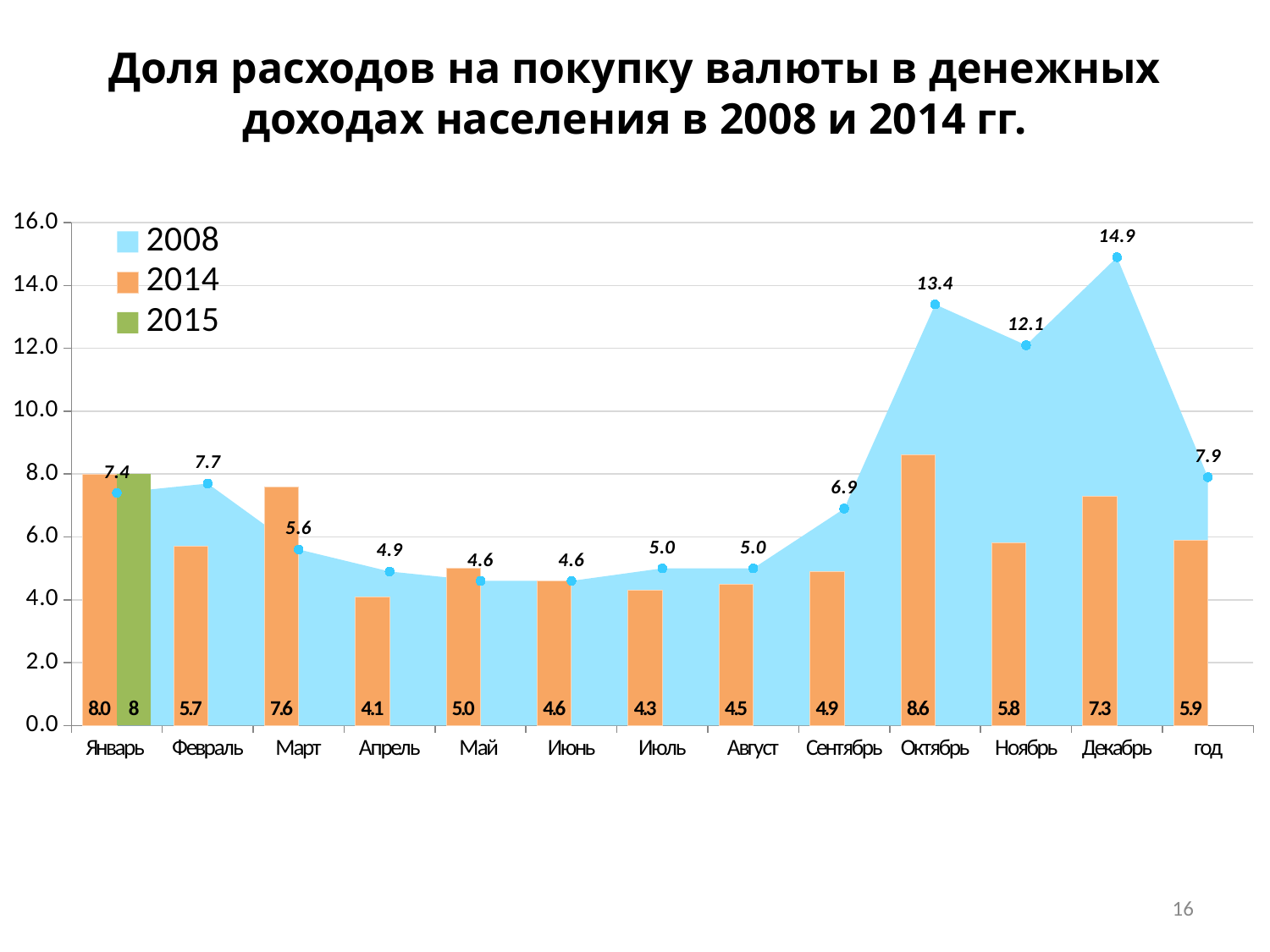
Which is larger for Март: the 2008 value or the 2014 value? 2014 What is the difference between the 2008 and 2014 values for Октябрь? 4.8 What is the 2014 value for Октябрь? 8.6 What is the 2015 value shown for Январь? 8 How many series does the legend list? 3 Does the 2008 series rise or fall from Сентябрь to Октябрь? rise Which month has the lowest 2014 value? Апрель How many categories are shown on the x axis? 13 What is the 2008 value for Декабрь? 14.9 Which month has the highest 2008 value? Декабрь Is the 2008 value for Ноябрь greater or less than 10.0? greater What is the 2008 value for the 'год' category? 7.9